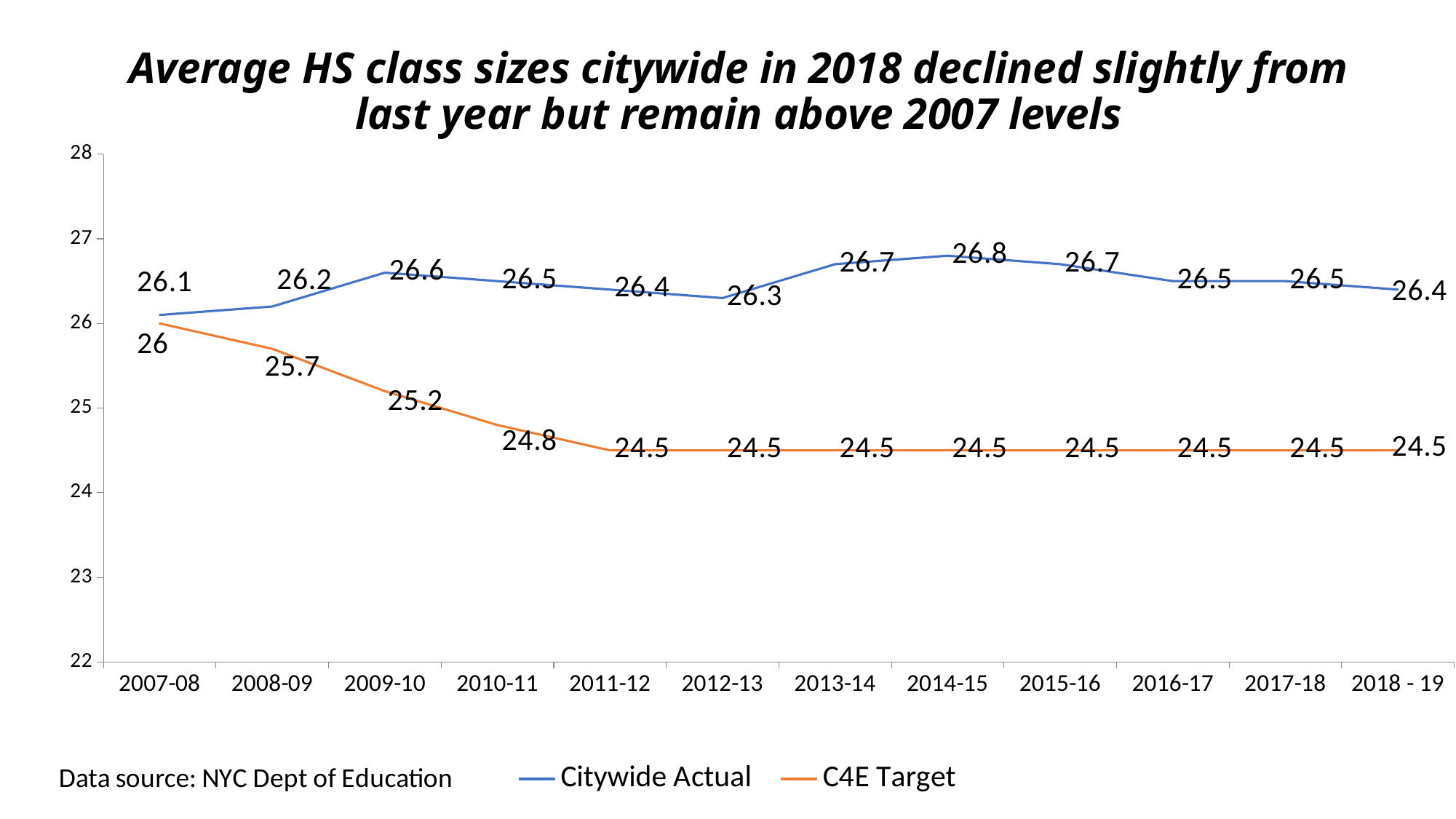
What is the difference between the Citywide Actual and C4E Target values in 2018 - 19? 1.9 Which is larger in 2007-08, the Citywide Actual value or the C4E Target value? Citywide Actual What is the Citywide Actual value for 2018 - 19? 26.4 What kind of chart is this? Line chart What is the C4E Target value for 2009-10? 25.2 In which year is the Citywide Actual value lowest? 2007-08 Does the C4E Target series rise or fall from 2007-08 to 2011-12? Fall What is the Citywide Actual value for 2014-15? 26.8 In which year is the Citywide Actual value highest? 2014-15 How many series does the legend list? 2 What is the data source stated on the slide? NYC Dept of Education How many years are shown on the x axis? 12